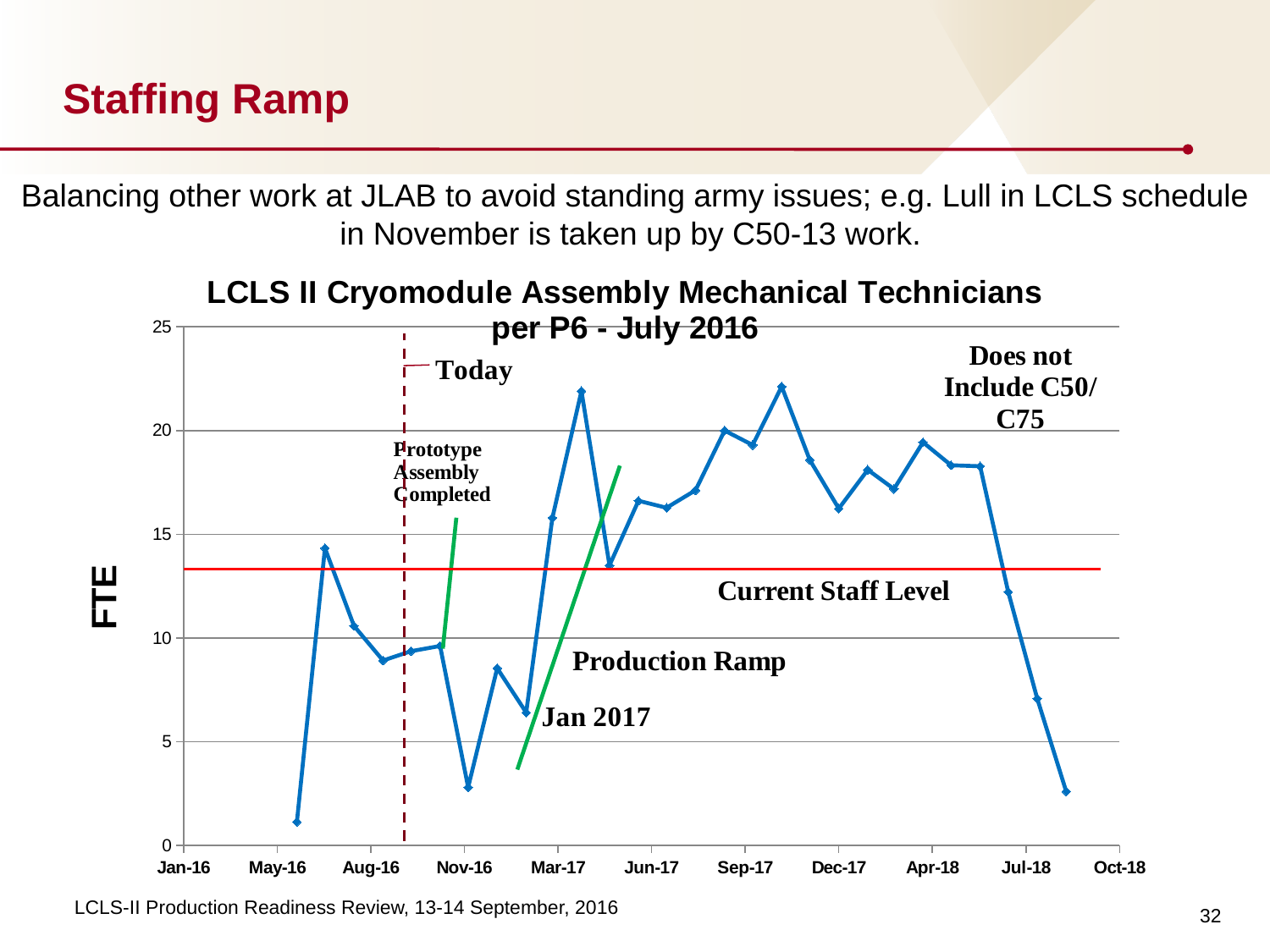
Is the value for Jun-17 greater or less than 15? greater Is the value for Dec-17 greater or less than 15? greater What kind of chart is shown on the slide? line chart What is the label on the vertical axis of the chart? FTE What is the title of the chart? LCLS II Cryomodule Assembly Mechanical Technicians per P6 - July 2016 Is the value for Jul-18 greater or less than 10? less Do the values rise or fall between Nov-16 and Mar-17? rise Which is larger, the value for Jun-17 or the value for Nov-16? Jun-17 Do the values rise or fall between Apr-18 and the last plotted point? fall